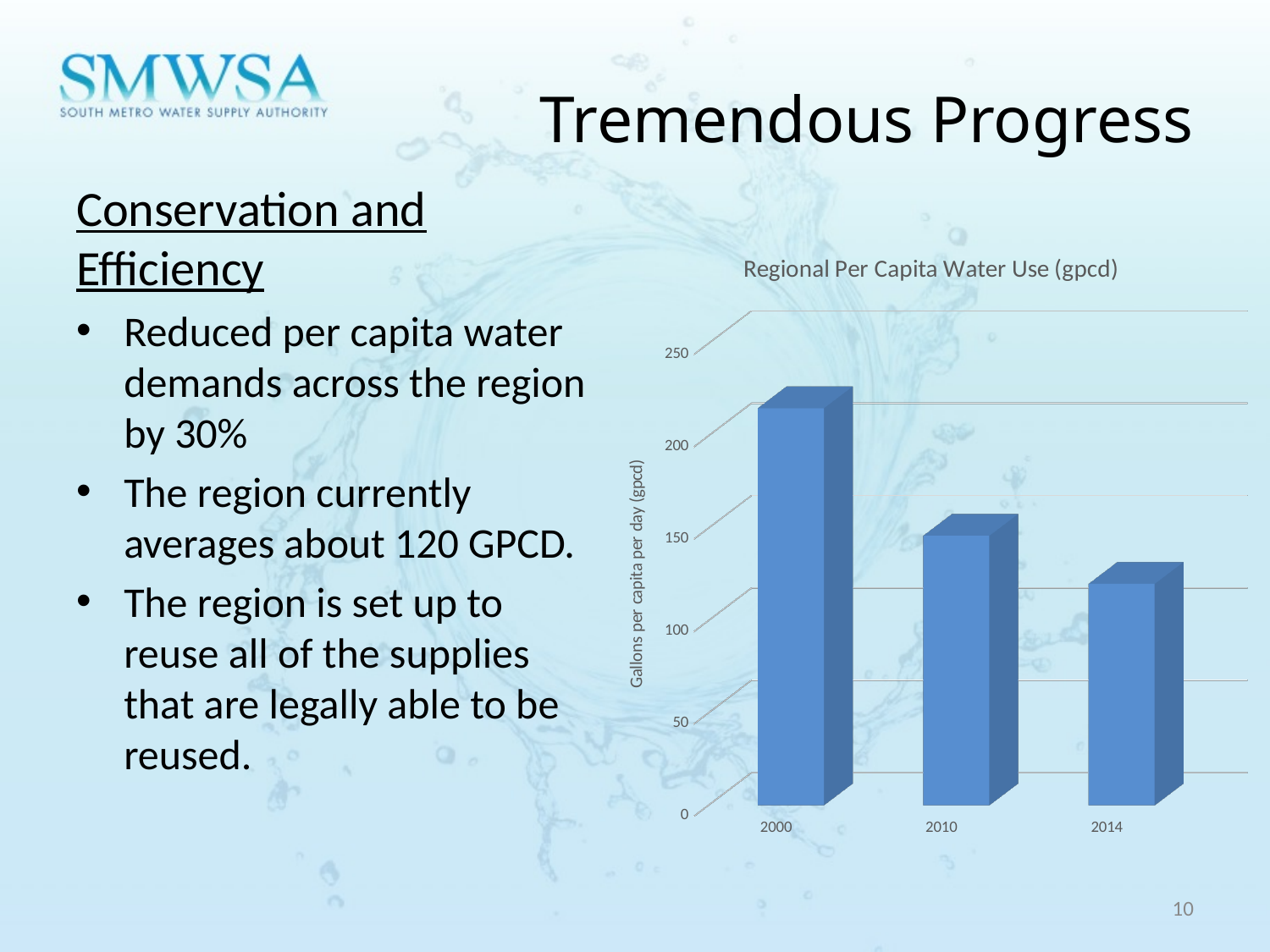
How many years are plotted on the chart? 3 Which year has the highest per capita water use? 2000 Is the value for 2010 greater or less than 100? greater What kind of chart is shown on the slide? bar chart Which year has a higher value, 2000 or 2010? 2000 Is the value for 2000 greater or less than 200? greater What is the title of the chart? Regional Per Capita Water Use (gpcd) Which year has the lowest per capita water use? 2014 Which year has a higher value, 2010 or 2014? 2010 What is the label on the vertical axis of the chart? Gallons per capita per day (gpcd) Is the value for 2014 greater or less than 150? less Do the values rise or fall from 2000 to 2014? fall